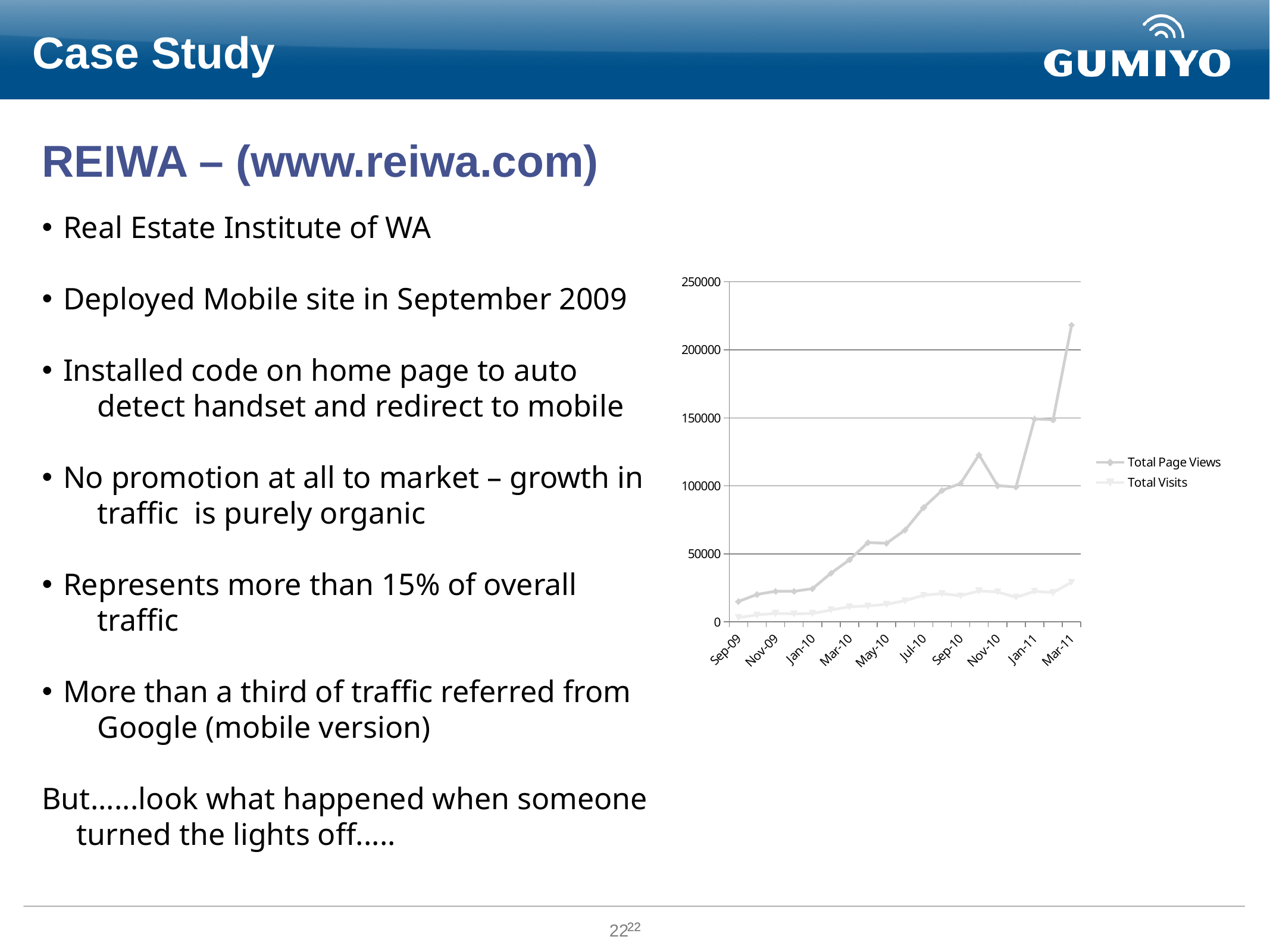
Is the value for Total Page Views in Sep-09 greater or less than 50000? less What kind of chart is shown on the slide? Line chart How many month labels are shown along the x axis of the chart? 10 How many series does the chart legend list? 2 What are the two series named in the chart legend? Total Page Views and Total Visits Is the value for Total Page Views in Mar-11 greater or less than 200000? greater Does Total Page Views generally rise or fall from Sep-09 to Mar-11? Rise In which month does Total Page Views reach its highest value? Mar-11 In Mar-11, which series has the larger value, Total Page Views or Total Visits? Total Page Views Is the value for Total Page Views in Jan-11 greater or less than 100000? greater In which month is Total Page Views at its lowest value? Sep-09